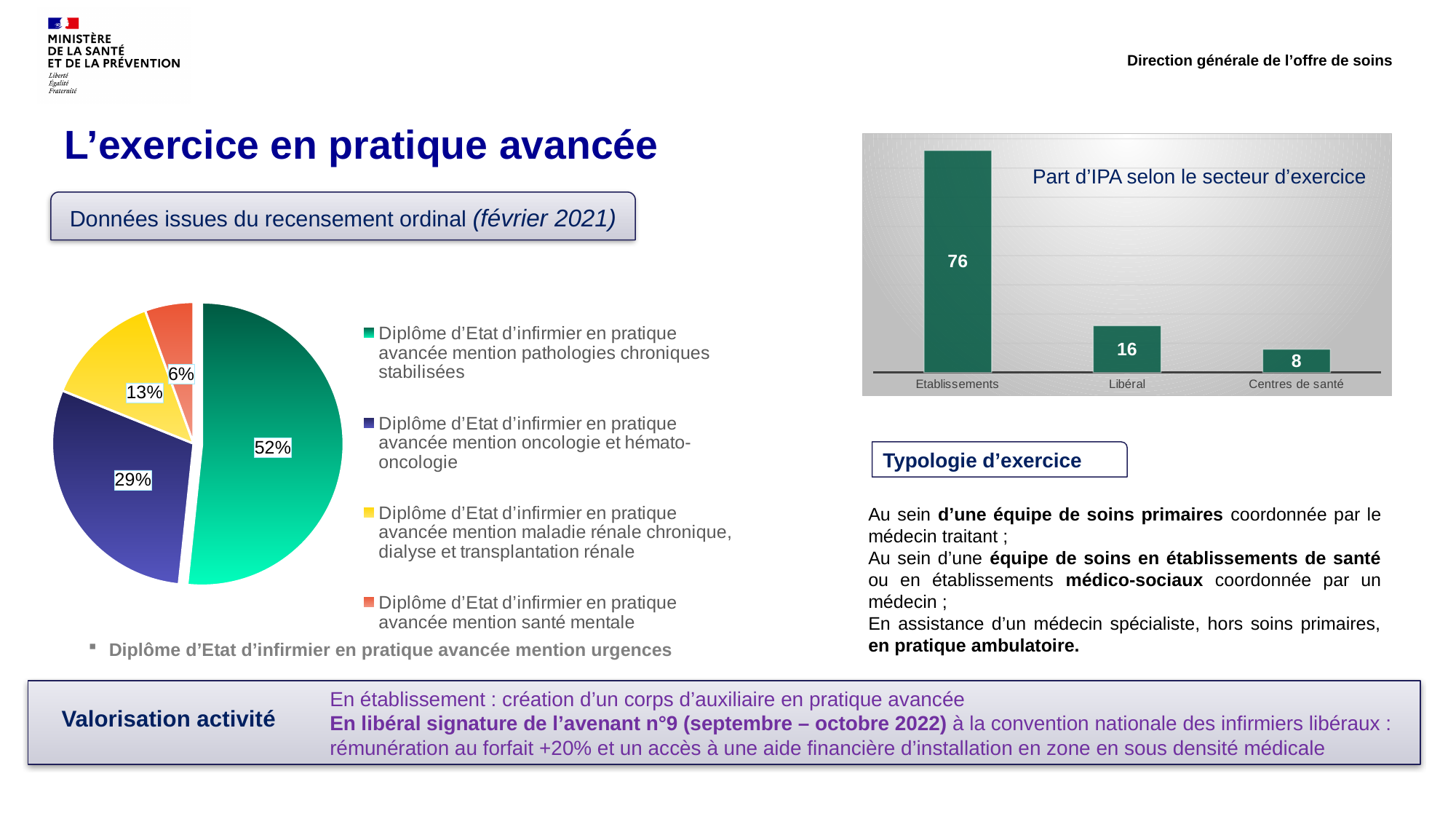
How many entries does the legend of the pie chart on the left list? 4 In the bar chart 'Part d'IPA selon le secteur d'exercice', what is the difference between the values for Etablissements and Libéral? 60 In the bar chart 'Part d'IPA selon le secteur d'exercice', what is the value for Centres de santé? 8 In the pie chart on the left, what share does the slice for 'Diplôme d'Etat d'infirmier en pratique avancée mention oncologie et hémato-oncologie' have? 29% In the bar chart 'Part d'IPA selon le secteur d'exercice', which category has the highest value? Etablissements In the bar chart 'Part d'IPA selon le secteur d'exercice', what is the value for Libéral? 16 What kind of chart is the chart titled 'Part d'IPA selon le secteur d'exercice'? Bar chart In the bar chart 'Part d'IPA selon le secteur d'exercice', which category has the lowest value? Centres de santé In the bar chart 'Part d'IPA selon le secteur d'exercice', what is the value for Etablissements? 76 In the pie chart on the left, which is larger: the slice for mention maladie rénale chronique, dialyse et transplantation rénale or the slice for mention santé mentale? Mention maladie rénale chronique, dialyse et transplantation rénale In the pie chart on the left, what share does the slice for 'Diplôme d'Etat d'infirmier en pratique avancée mention pathologies chroniques stabilisées' have? 52% In the bar chart 'Part d'IPA selon le secteur d'exercice', how many categories are shown? 3